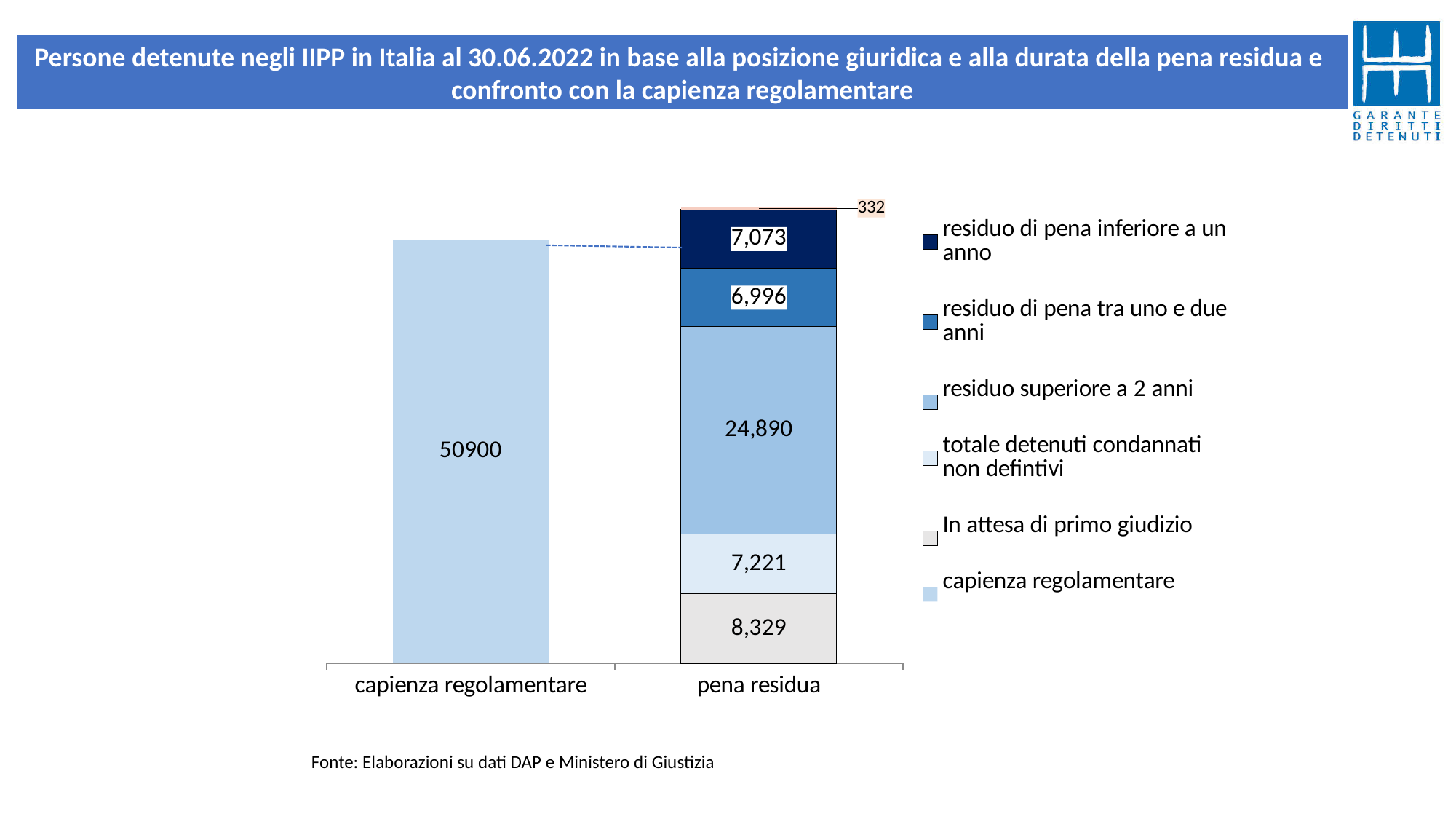
In the 'pena residua' bar, what is the value for 'In attesa di primo giudizio'? 8,329 Which is larger: the 'residuo di pena inferiore a un anno' segment or the 'residuo di pena tra uno e due anni' segment? residuo di pena inferiore a un anno What is the value of the 'capienza regolamentare' bar? 50900 What is the difference between the 'residuo superiore a 2 anni' segment and the 'In attesa di primo giudizio' segment? 16,561 How many categories are shown on the x axis? 2 In the 'pena residua' bar, what is the value for 'residuo di pena tra uno e due anni'? 6,996 Which segment of the 'pena residua' bar is the largest? residuo superiore a 2 anni How many entries does the legend list? 6 In the 'pena residua' bar, what is the value for 'totale detenuti condannati non defintivi'? 7,221 In the 'pena residua' bar, what is the value for 'residuo di pena inferiore a un anno'? 7,073 In the 'pena residua' bar, what is the value for 'residuo superiore a 2 anni'? 24,890 What kind of chart is shown on the slide? Stacked bar chart